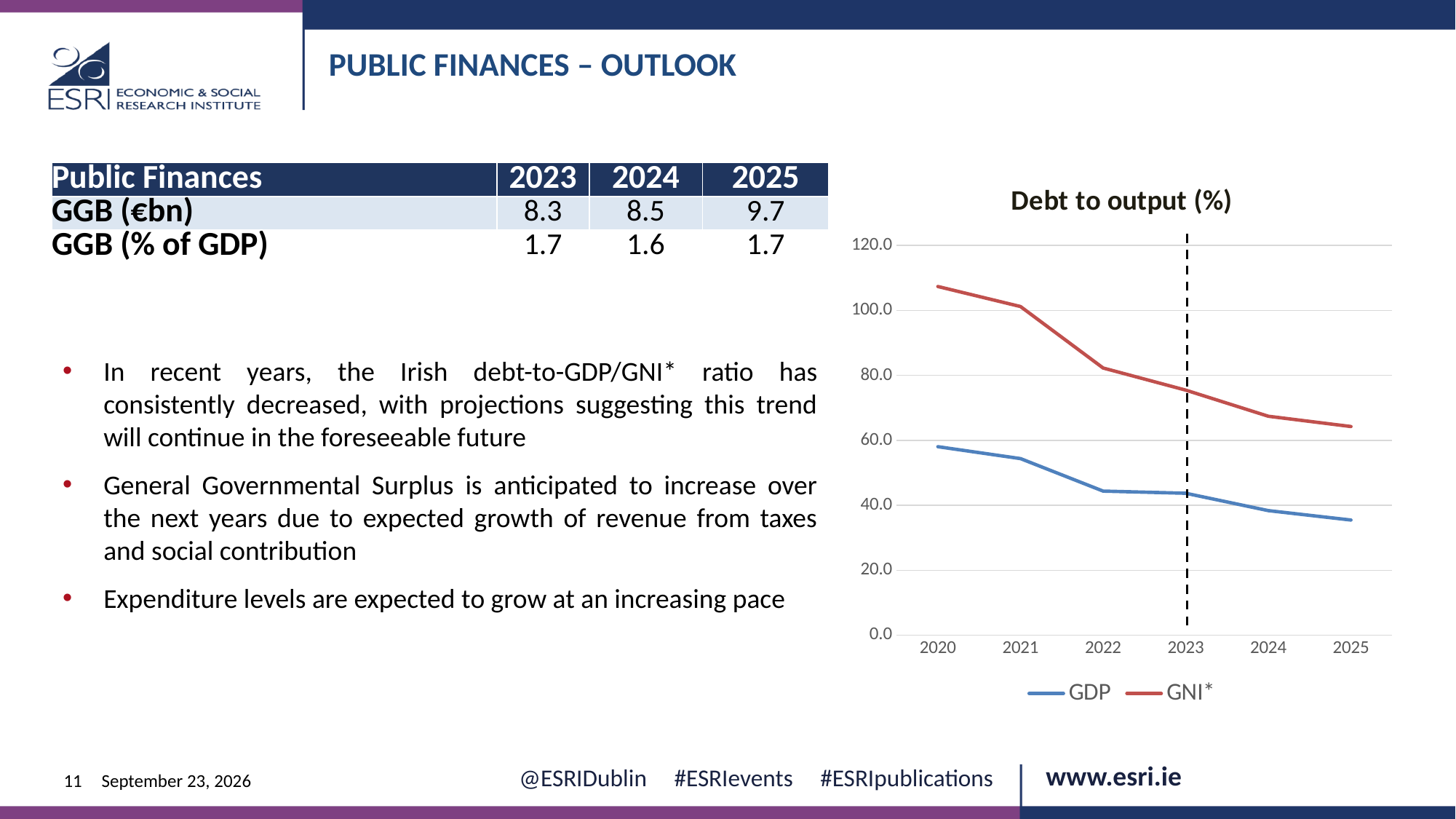
In which year is the GNI* series at its highest? 2020 Is the value for GNI* in 2023 greater or less than 80? less What kind of chart is shown on the slide? line chart How many years are plotted along the x axis of the chart? 6 In 2023, which series has the larger value, GDP or GNI*? GNI* Is the value for GNI* in 2020 greater or less than 100? greater Is the value for GDP in 2025 greater or less than 40? less What is the title of the chart on the slide? Debt to output (%) How many series does the chart's legend list? 2 In which year is the GDP series at its lowest? 2025 Do the values of the GNI* series rise or fall from 2020 to 2025? fall Which series is drawn in red on the chart? GNI*